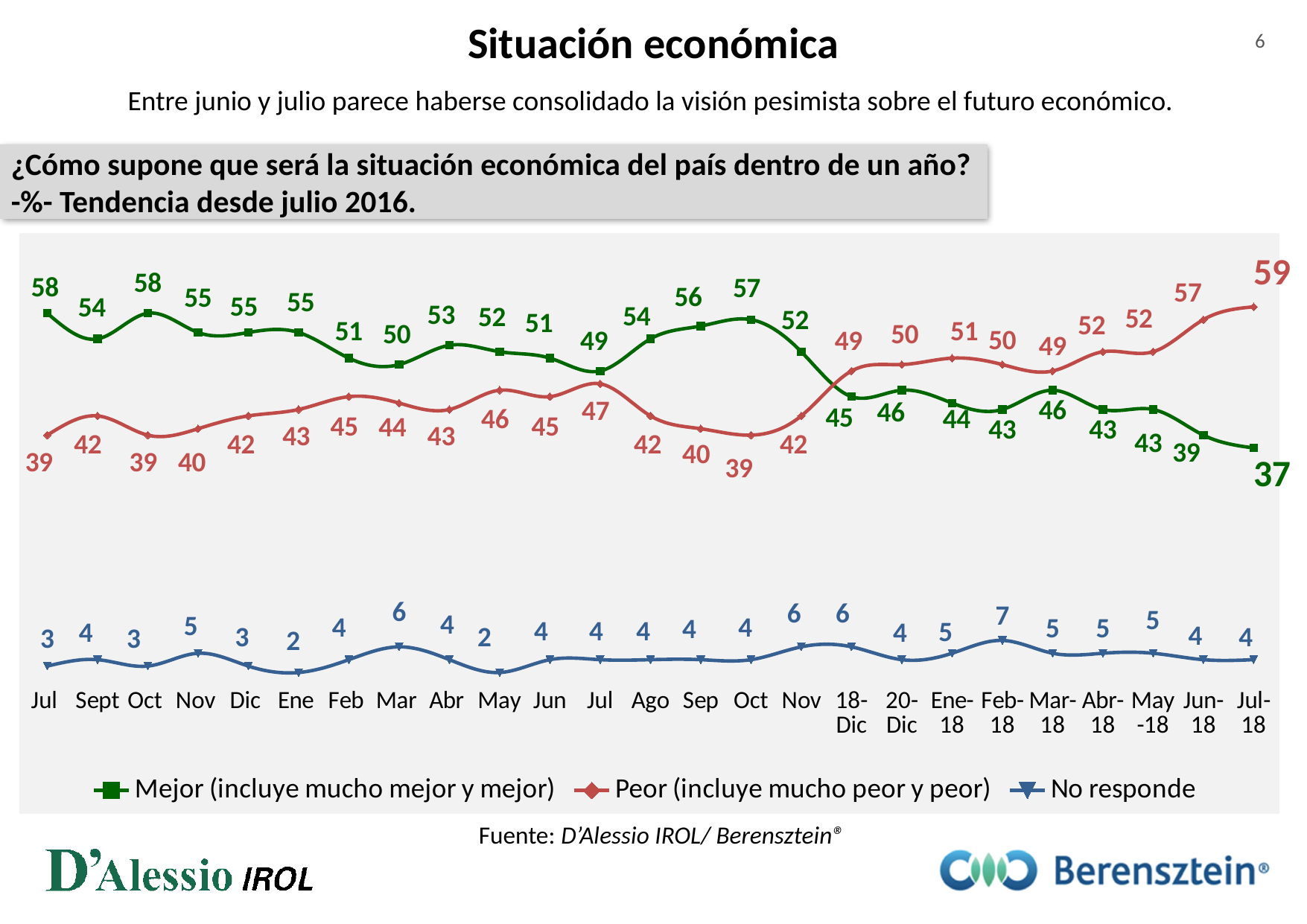
What is the difference between the 'Peor' and 'Mejor' values at Jul-18? 22 What is the value of the 'Peor (incluye mucho peor y peor)' series at the first Jul point? 39 What kind of chart is shown on the slide? Line chart What is the value of the 'Peor (incluye mucho peor y peor)' series at Jul-18? 59 At which point does the 'Peor (incluye mucho peor y peor)' series reach its highest value? Jul-18 What is the value of the 'Mejor (incluye mucho mejor y mejor)' series at Jul-18? 37 How many points are plotted along the x axis for each series? 25 Does the 'Mejor (incluye mucho mejor y mejor)' series rise or fall from Oct (2017) to Jul-18? Fall What is the value of the 'No responde' series at Feb-18? 7 How many series does the legend list? 3 At which point does the 'Mejor (incluye mucho mejor y mejor)' series reach its lowest value? Jul-18 At Oct (2017), which is larger: the 'Mejor' value or the 'Peor' value? Mejor